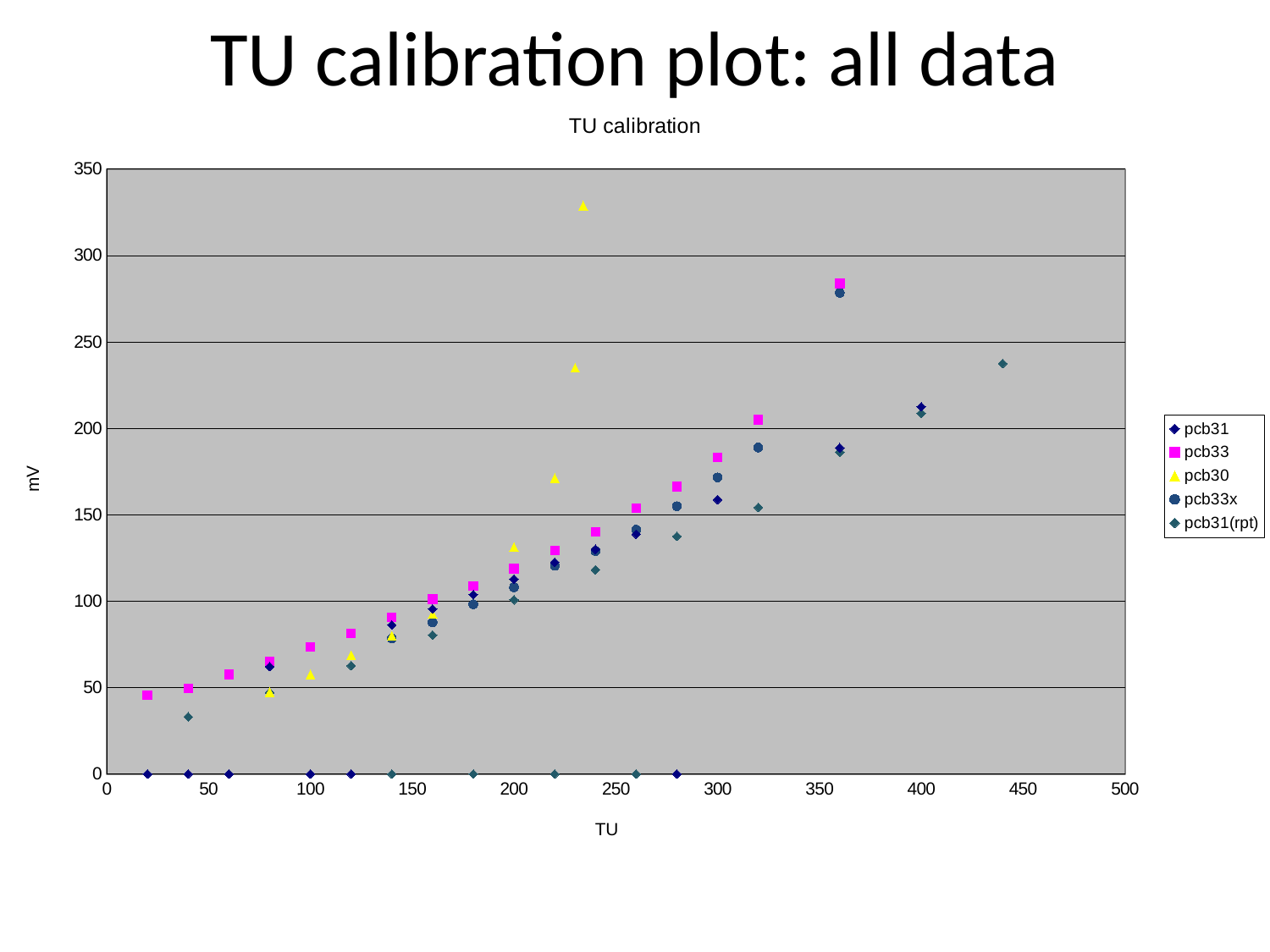
Is the highest pcb30 point (near TU 230) greater or less than 300 mV? greater What kind of chart is shown on the slide? Scatter chart Which series has the highest plotted point on the chart? pcb30 At TU 360, which series has the larger mV value: pcb33 or pcb31? pcb33 How many series does the legend list? 5 What label is shown on the vertical axis of the chart? mV Is the pcb31(rpt) value at TU 440 greater or less than 250 mV? less What is the highest tick value shown on the horizontal (TU) axis? 500 Is the pcb33 value at TU 360 greater or less than 250 mV? greater Do the mV values for pcb33 generally rise or fall as TU increases? rise What is the title printed above the chart's plot area? TU calibration